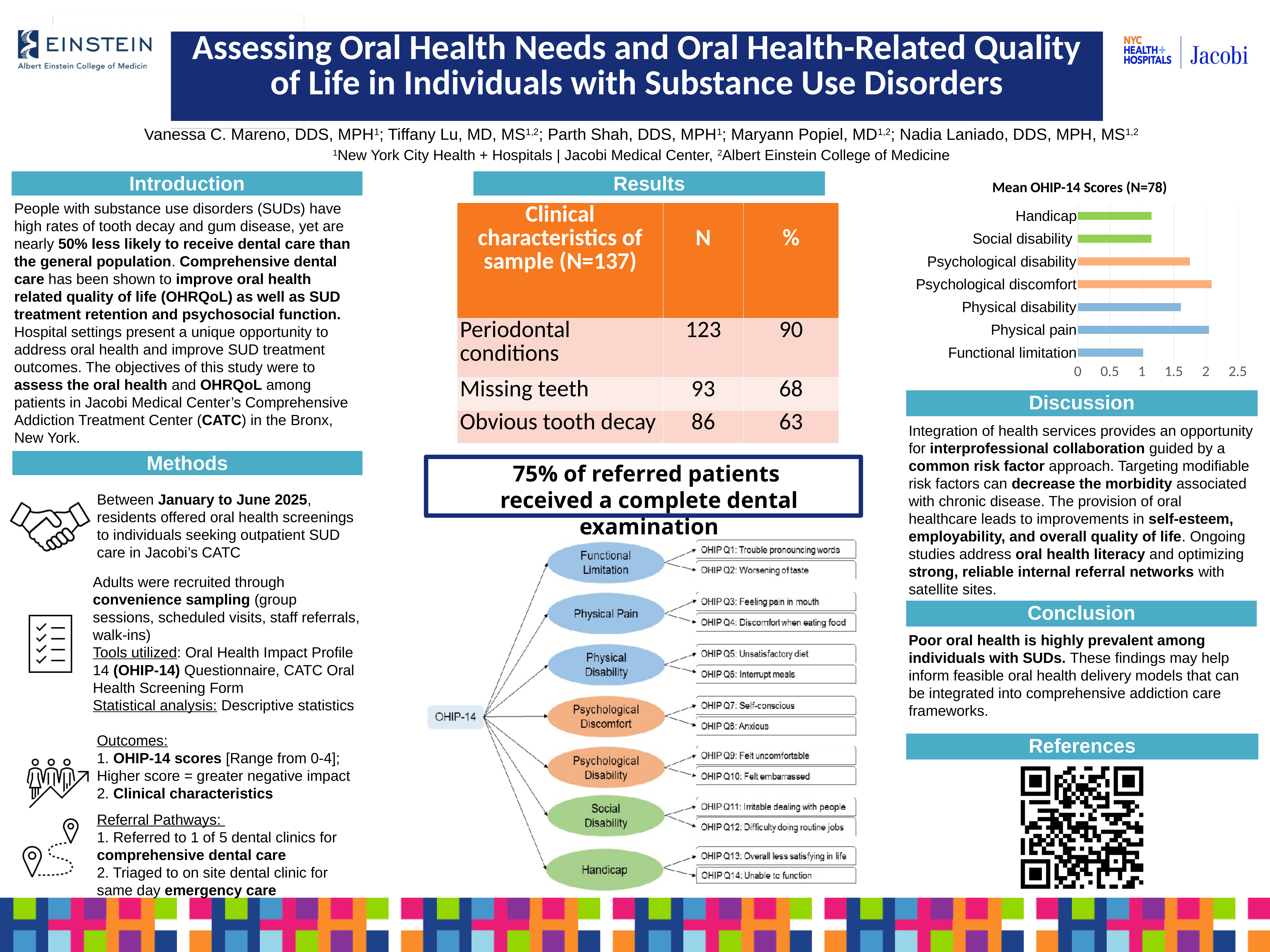
What kind of chart is used to show the Mean OHIP-14 Scores? Bar chart In the Mean OHIP-14 Scores chart, is the value for Physical disability greater or less than 1.5? greater In the Mean OHIP-14 Scores chart, is the value for Psychological discomfort greater or less than 2? greater In the Mean OHIP-14 Scores chart, is the value for Functional limitation greater or less than 1.5? less In the Mean OHIP-14 Scores chart, which is larger: Psychological discomfort or Functional limitation? Psychological discomfort In the Mean OHIP-14 Scores chart, which category has the lowest mean score? Functional limitation In the Mean OHIP-14 Scores chart, which is larger: Physical pain or Physical disability? Physical pain What is the highest value shown on the x axis of the Mean OHIP-14 Scores chart? 2.5 How many categories are plotted in the Mean OHIP-14 Scores chart? 7 What is the title of the chart on the slide? Mean OHIP-14 Scores (N=78)